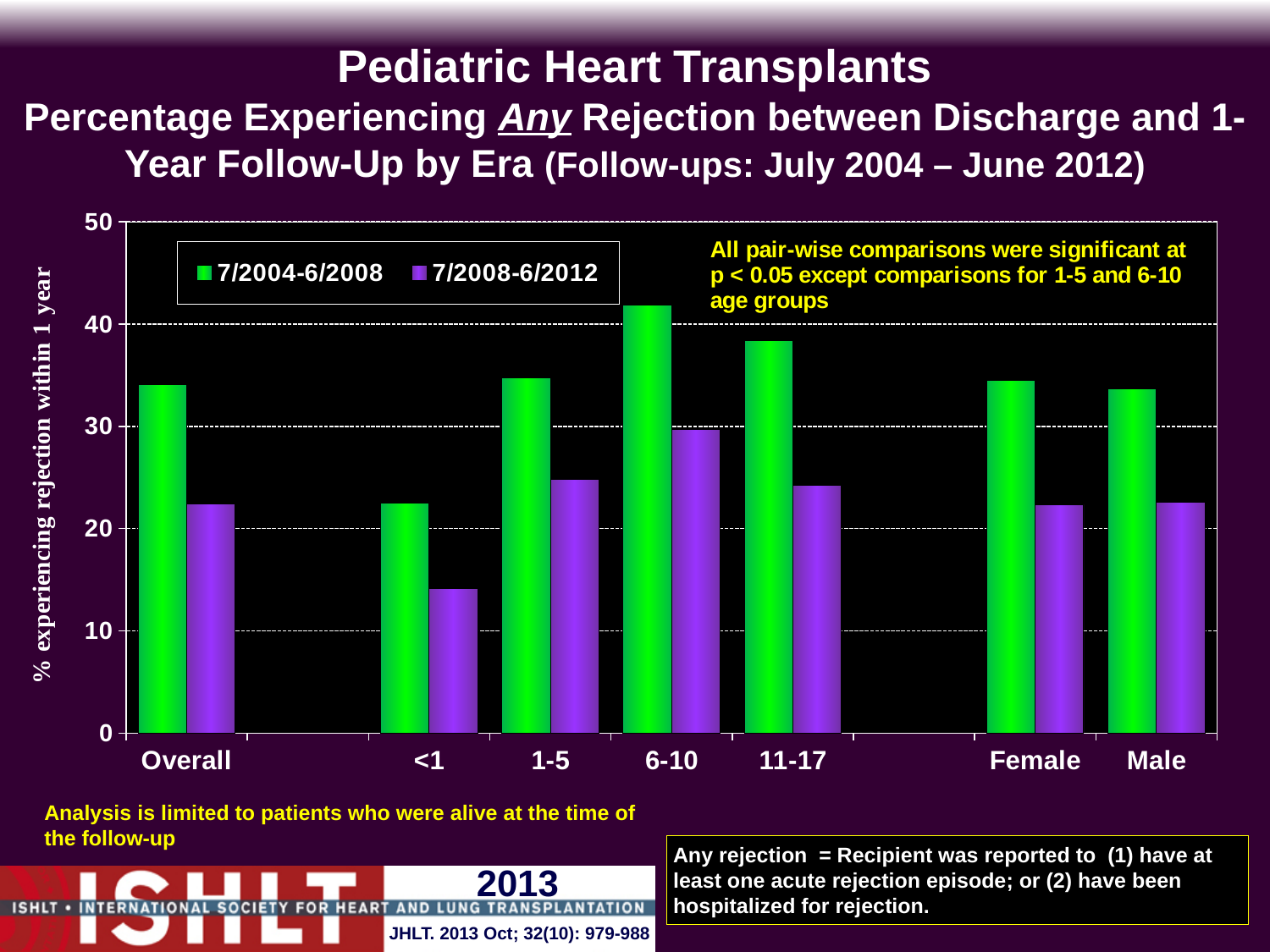
Which category has the highest value for the 7/2004-6/2008 series? 6-10 How many categories are shown along the x axis? 7 For the 7/2008-6/2012 series, which is larger: the 6-10 age group or the <1 age group? 6-10 Which category has the lowest value for the 7/2008-6/2012 series? <1 What are the two era labels listed in the legend? 7/2004-6/2008 and 7/2008-6/2012 How many series does the legend list? 2 Is the 7/2004-6/2008 value for the 6-10 age group greater or less than 40? greater For the 7/2004-6/2008 series, which is larger: the 6-10 age group or the 11-17 age group? 6-10 Which category has the lowest value for the 7/2004-6/2008 series? <1 What kind of chart is shown on the slide? bar chart Is the 7/2004-6/2008 value for Overall greater or less than 30? greater Is the 7/2008-6/2012 value for the <1 age group greater or less than 20? less